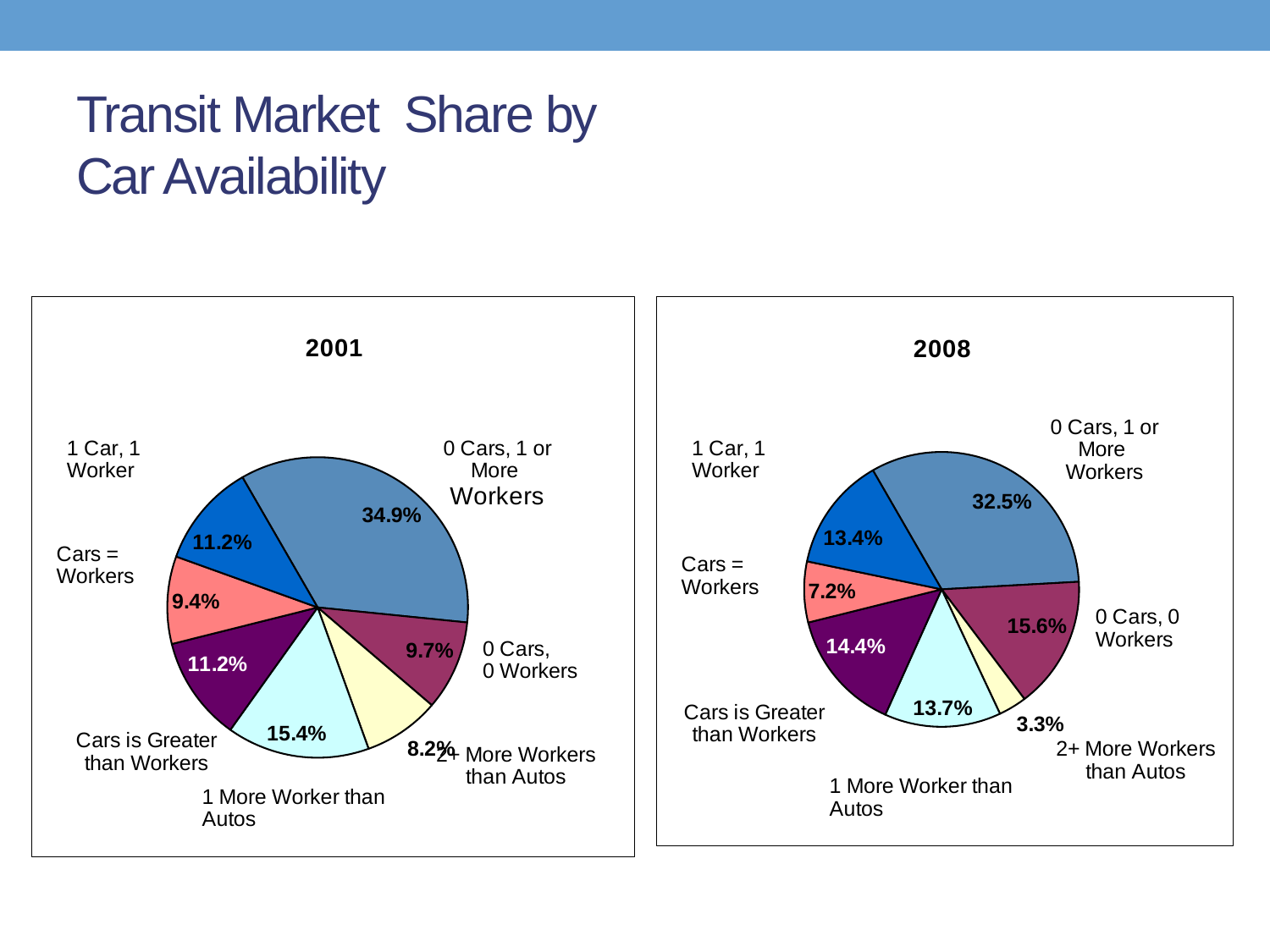
In the 2008 chart, which category has the smallest slice? 2+ More Workers than Autos What is the difference between the 0 Cars, 1 or More Workers share in the 2001 chart and in the 2008 chart? 2.4% In the 2001 chart, what share is labelled for the 0 Cars, 1 or More Workers slice? 34.9% In the 2008 chart, what share is labelled for the 0 Cars, 0 Workers slice? 15.6% What type of chart is used for the 2001 data? Pie chart In the 2008 chart, what share is labelled for the 2+ More Workers than Autos slice? 3.3% In the 2001 chart, which category has the smallest slice? 2+ More Workers than Autos In the 2001 chart, which category has the largest slice? 0 Cars, 1 or More Workers In the 2008 chart, which is larger: the Cars is Greater than Workers slice or the Cars = Workers slice? Cars is Greater than Workers What is the title of the chart on the right side of the slide? 2008 In the 2001 chart, what share is labelled for the 1 More Worker than Autos slice? 15.4% How many slices does the 2008 pie chart have? 7